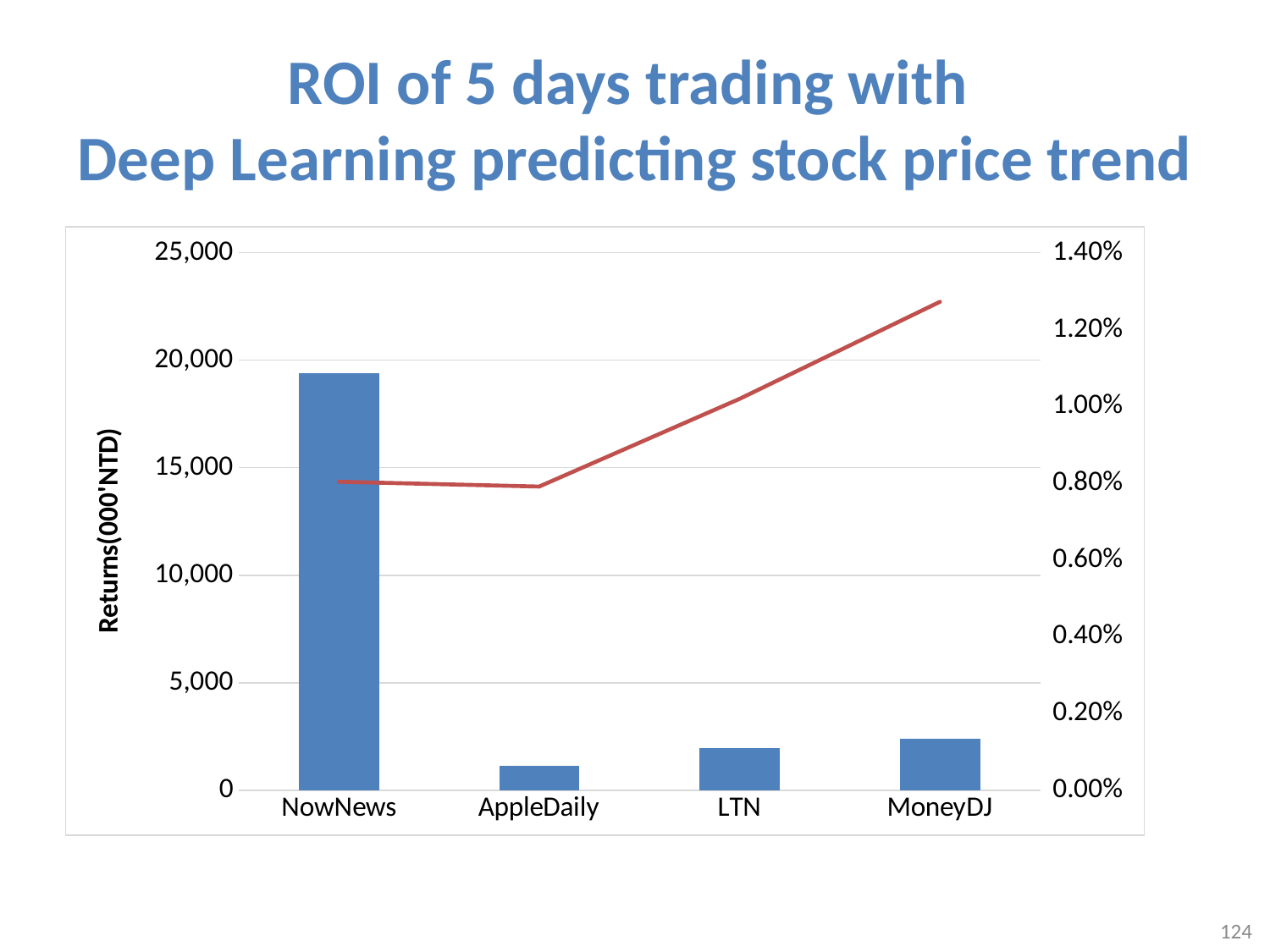
What is the label of the left vertical axis? Returns(000'NTD) Is the bar value for MoneyDJ greater or less than 5,000? less Is the bar value for NowNews greater or less than 15,000? greater How many categories are shown on the x axis? 4 Is the bar value for AppleDaily greater or less than 5,000? less Does the red line rise or fall from AppleDaily to MoneyDJ? rise Which has the taller bar, LTN or MoneyDJ? MoneyDJ What kind of chart is shown on the slide? A combined bar and line chart Which category has the shortest bar? AppleDaily Which category has the tallest bar? NowNews At which category does the red line reach its highest point? MoneyDJ